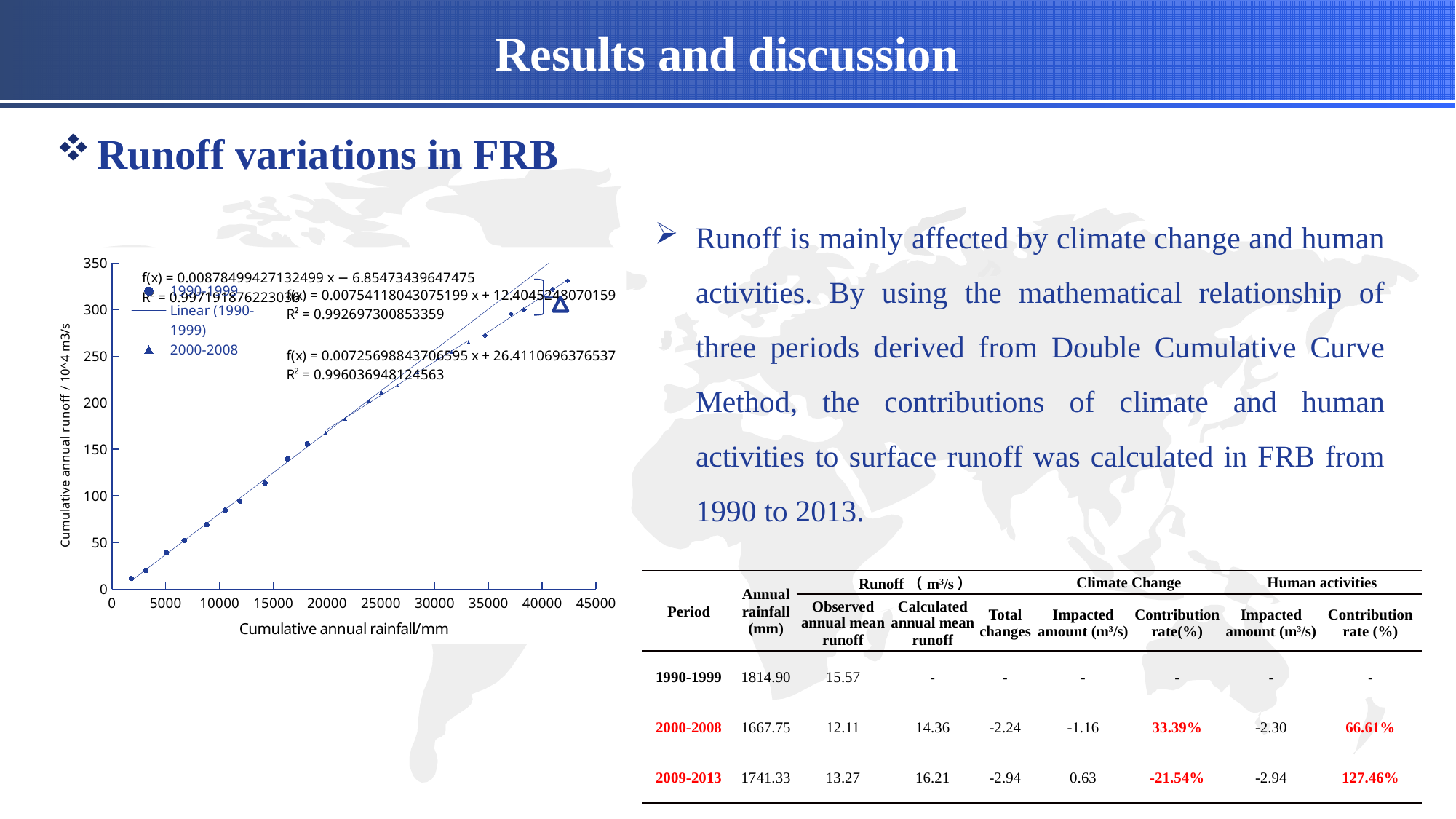
What is the R² value printed for the trendline f(x) = 0.00878499427132499 x − 6.85473439647475? 0.997191876223036 What is the slope of the trendline whose R² is 0.996036948124563? 0.00725698843706595 Is the cumulative annual runoff at a cumulative rainfall of about 5000 mm greater or less than 50? less What is the highest tick value shown on the x axis of the chart? 45000 Is the highest plotted cumulative annual runoff value greater or less than 300? greater What is the title of the x axis of the chart? Cumulative annual rainfall/mm What is the title of the y axis of the chart? Cumulative annual runoff / 10^4 m3/s What kind of chart is shown on the left of the slide? scatter chart What is the highest tick value shown on the y axis of the chart? 350 Do the plotted values rise or fall as cumulative annual rainfall increases along the x axis? rise What is the R² value printed for the trendline f(x) = 0.00754118043075199 x + 12.4045248070159? 0.992697300853359 Which has the larger cumulative annual runoff: the point at about 40000 mm cumulative rainfall or the point at about 20000 mm? the point at about 40000 mm